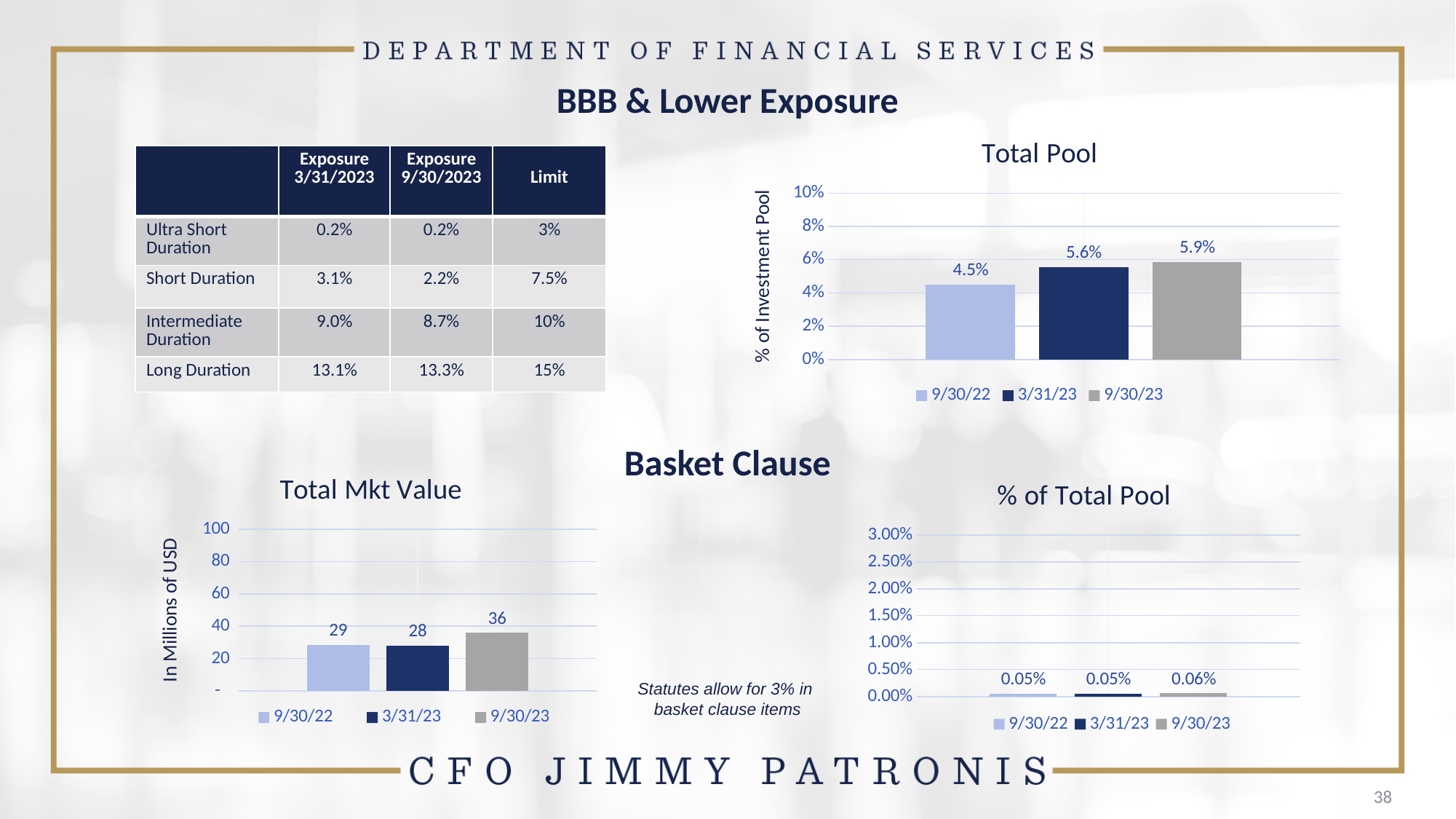
In the Total Pool chart, which date has the highest value? 9/30/23 In the Total Pool chart, what is the value for 9/30/22? 4.5% What kind of chart is the Total Mkt Value chart? bar chart In the Total Mkt Value chart, which date has the lowest value? 3/31/23 In the Total Pool chart, what is the difference between the 9/30/23 and 9/30/22 values? 1.4% In the % of Total Pool chart, what is the value for 9/30/22? 0.05% In the Total Pool chart, what is the value for 9/30/23? 5.9% In the Total Pool chart, how many series does the legend list? 3 In the Total Mkt Value chart, what is the difference between the 9/30/23 and 3/31/23 values? 8 In the Total Mkt Value chart, is the value for 9/30/23 greater or less than 40? less In the Total Mkt Value chart, what is the value for 3/31/23? 28 In the % of Total Pool chart, what is the value for 9/30/23? 0.06%